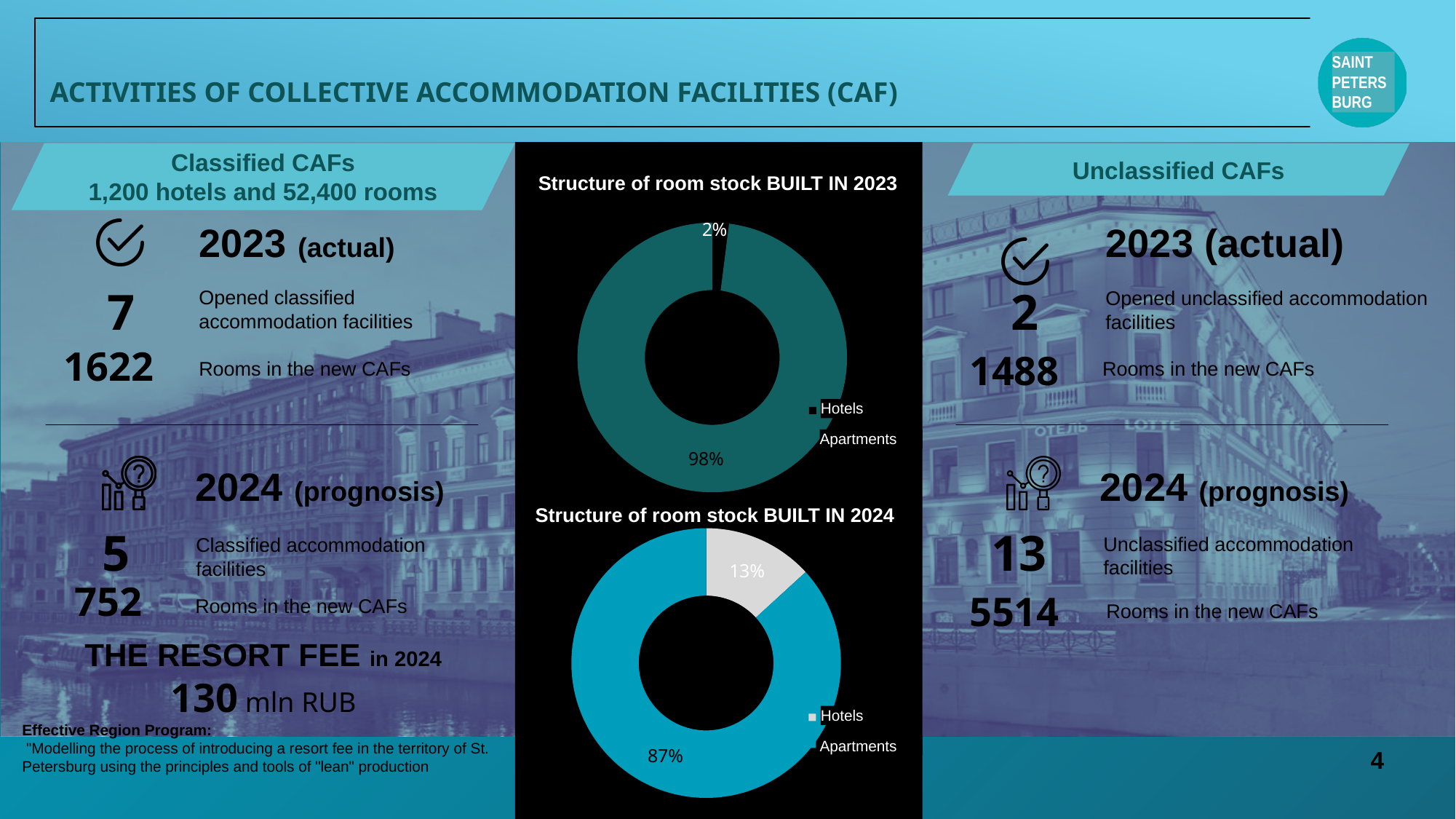
In the 'Structure of room stock BUILT IN 2023' chart, which category has the smallest share? Hotels What kind of chart is 'Structure of room stock BUILT IN 2023'? Pie chart (donut) How many slices does the 'Structure of room stock BUILT IN 2023' chart have? 2 In the 'Structure of room stock BUILT IN 2023' chart, what share is labelled for Hotels? 2% In the 'Structure of room stock BUILT IN 2024' chart, what is the difference between the Apartments share and the Hotels share? 74% What colour is the Hotels slice in the 'Structure of room stock BUILT IN 2024' chart? Light grey How many categories does the legend of the 'Structure of room stock BUILT IN 2024' chart list? 2 In the 'Structure of room stock BUILT IN 2024' chart, which category has the largest share? Apartments In the 'Structure of room stock BUILT IN 2024' chart, what share is labelled for Hotels? 13% In the 'Structure of room stock BUILT IN 2023' chart, what share is labelled for Apartments? 98% Is the Hotels share larger in the 'Structure of room stock BUILT IN 2023' chart or in the 'Structure of room stock BUILT IN 2024' chart? BUILT IN 2024 In the 'Structure of room stock BUILT IN 2024' chart, what share is labelled for Apartments? 87%